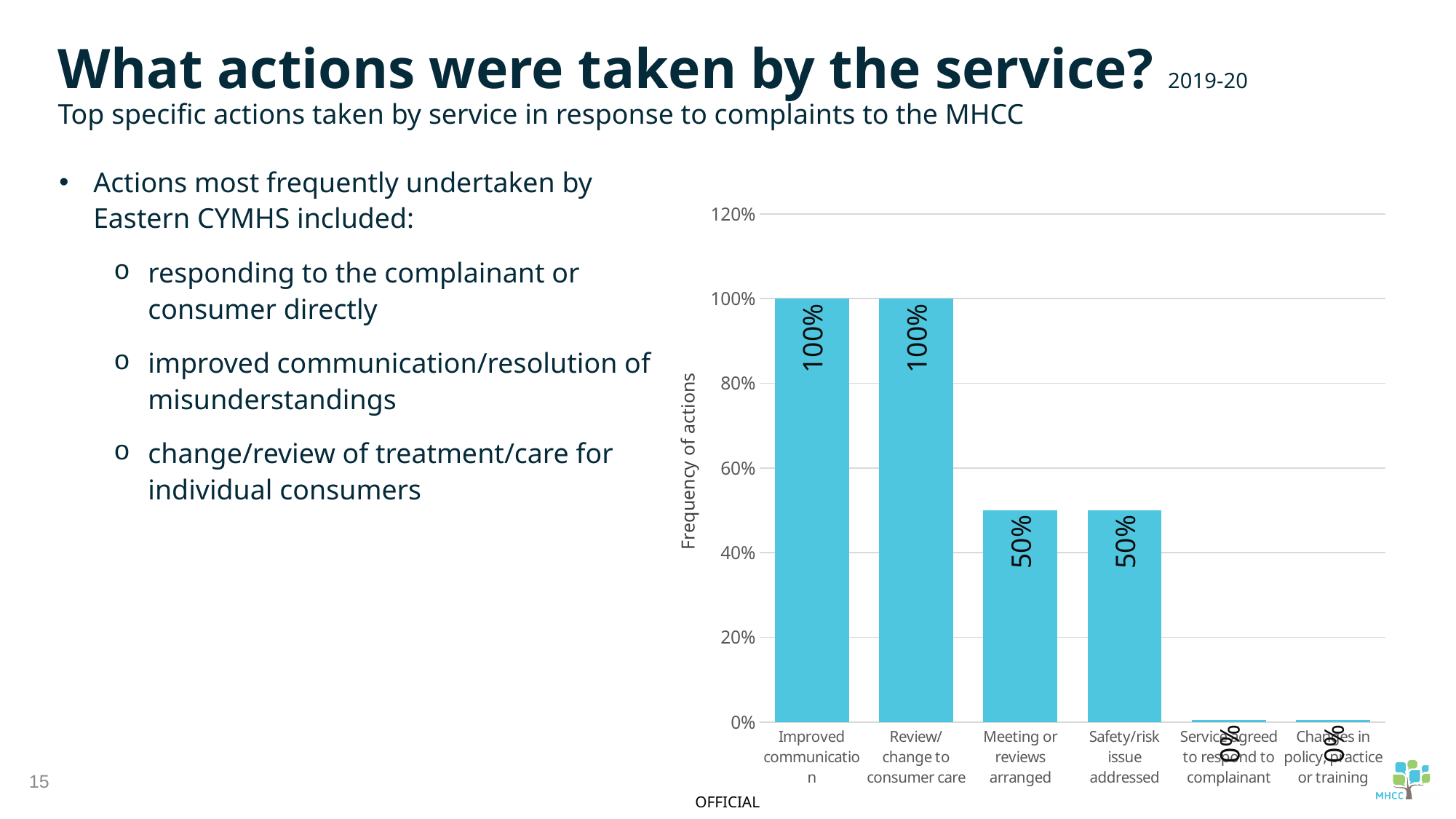
What is the value for Meeting or reviews arranged? 50% What is the difference between the values for Review/change to consumer care and Meeting or reviews arranged? 50% What is the value for Changes in policy, practice or training? 0% What is the value for Safety/risk issue addressed? 50% What is the value for Service agreed to respond to complainant? 0% Which is larger, the value for Review/change to consumer care or the value for Safety/risk issue addressed? Review/change to consumer care What is the value for Improved communication? 100% How many categories are shown on the x axis of the chart? 6 What kind of chart is shown on the slide? bar chart Do the values rise or fall from left to right along the x axis? fall What is the label of the vertical axis of the chart? Frequency of actions Is the value for Meeting or reviews arranged greater or less than 80%? less